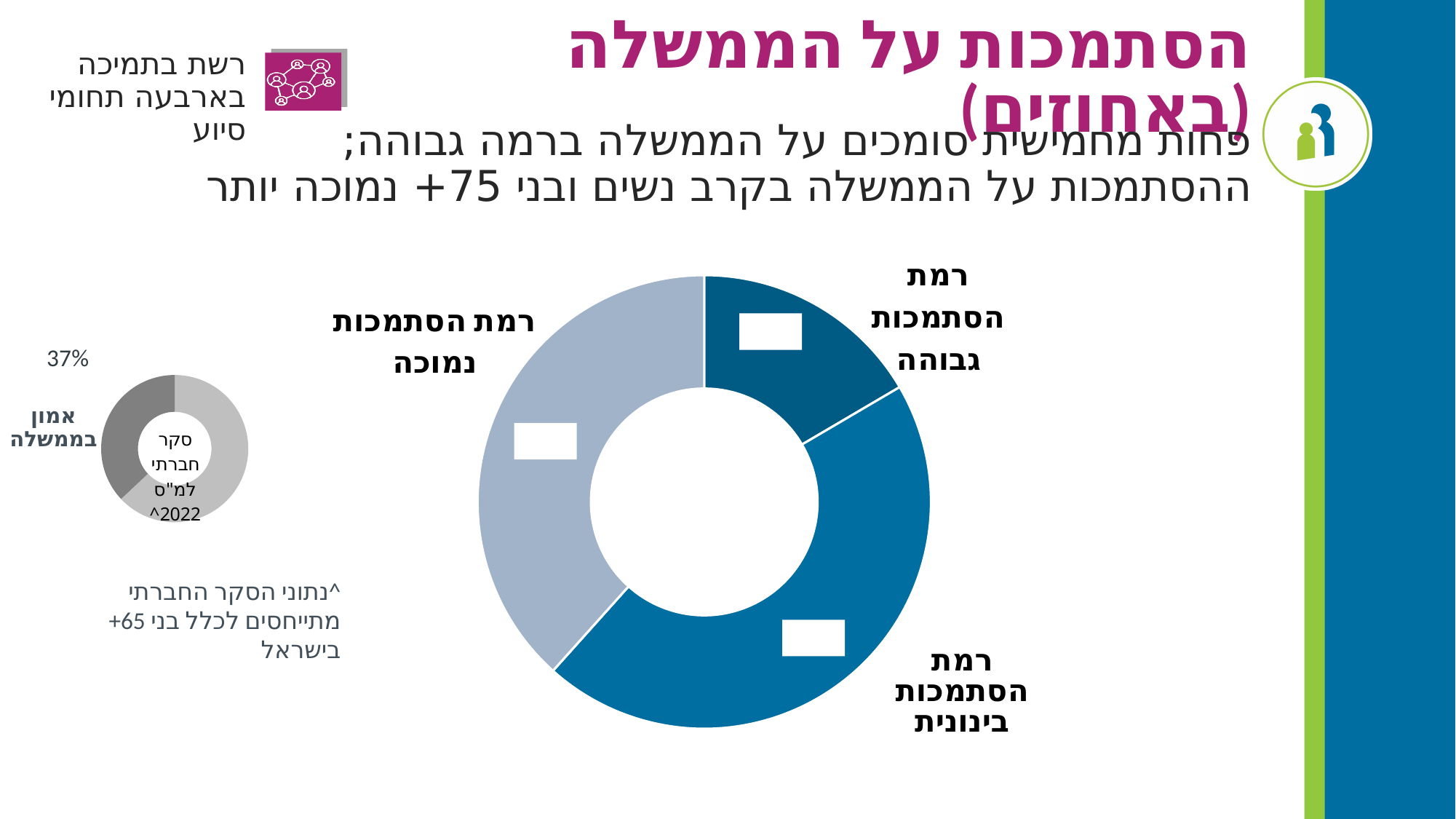
In the small donut chart on the left of the slide, is the value for אמון בממשלה greater or less than 50%? less What kind of chart is the large chart in the centre of the slide? Donut (pie) chart How many slices does the small donut chart on the left of the slide have? 2 In the large donut chart in the centre of the slide, which slice is larger: רמת הסתמכות גבוהה or רמת הסתמכות נמוכה? רמת הסתמכות נמוכה In the large donut chart in the centre of the slide, what colour is the slice for רמת הסתמכות נמוכה? Light grey-blue In the large donut chart in the centre of the slide, which category has the smallest slice? רמת הסתמכות גבוהה How many categories does the large donut chart in the centre of the slide show? 3 In the large donut chart in the centre of the slide, which slice is larger: רמת הסתמכות גבוהה or רמת הסתמכות בינונית? רמת הסתמכות בינונית What kind of chart is the small chart on the left of the slide labelled אמון בממשלה? Donut (pie) chart In the small donut chart on the left of the slide, what value is shown for אמון בממשלה? 37% What is the title of the slide containing the large donut chart? הסתמכות על הממשלה (באחוזים)